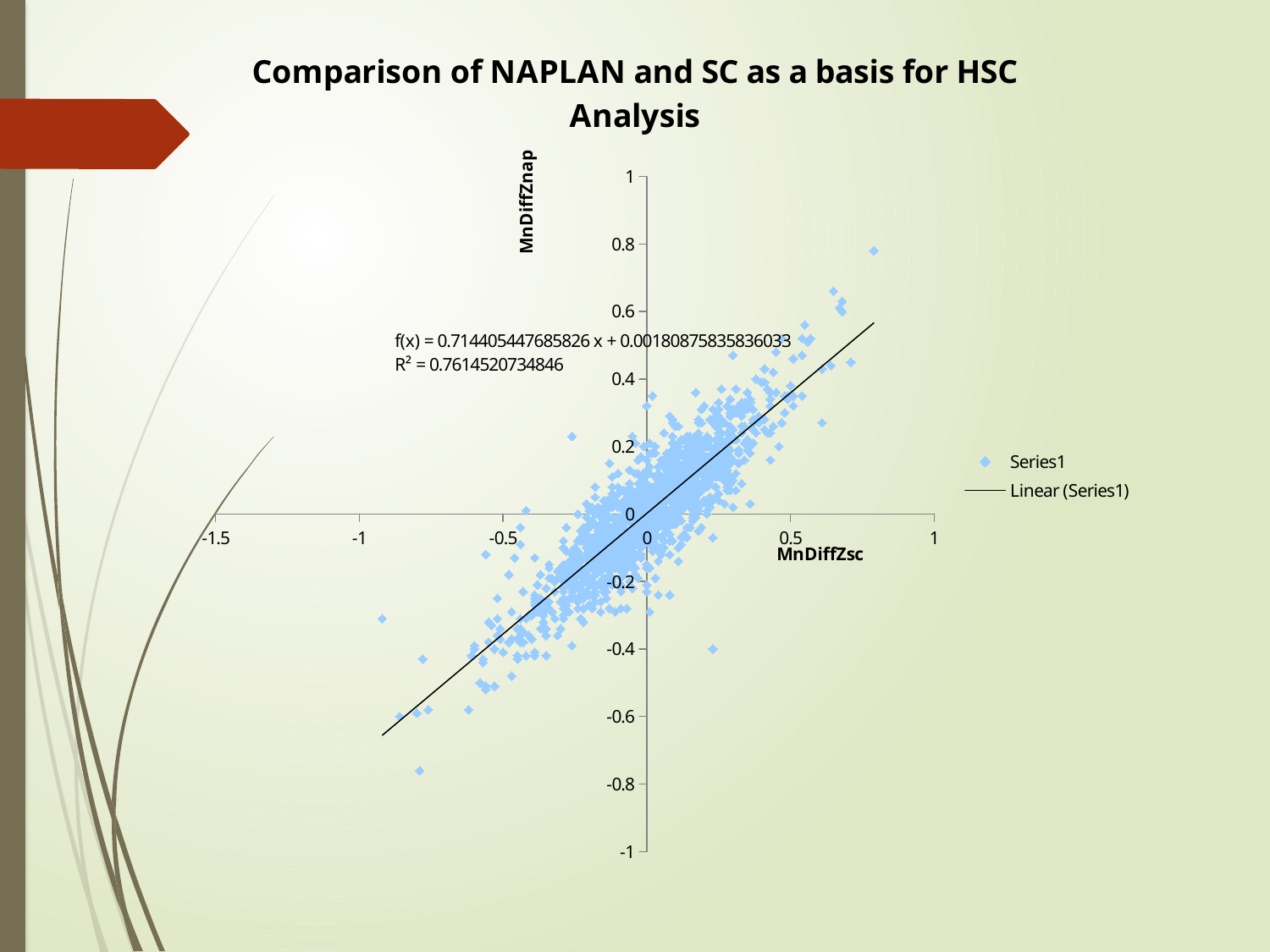
Is the MnDiffZnap value of the lowest plotted point greater or less than -0.6? less What is the R² value printed on the chart? R² = 0.7614520734846 What is the title of the chart? Comparison of NAPLAN and SC as a basis for HSC Analysis Do the plotted points generally rise or fall as MnDiffZsc increases? Rise Is the MnDiffZnap value of the highest plotted point greater or less than 0.6? greater What are the labels of the x axis and y axis? MnDiffZsc (x axis) and MnDiffZnap (y axis) What is the slope of the fitted line f(x) printed on the chart? 0.714405447685826 How many entries does the chart legend list? 2 What kind of chart is shown on the slide? Scatter plot What is the intercept of the fitted line f(x) printed on the chart? 0.00180875835836033